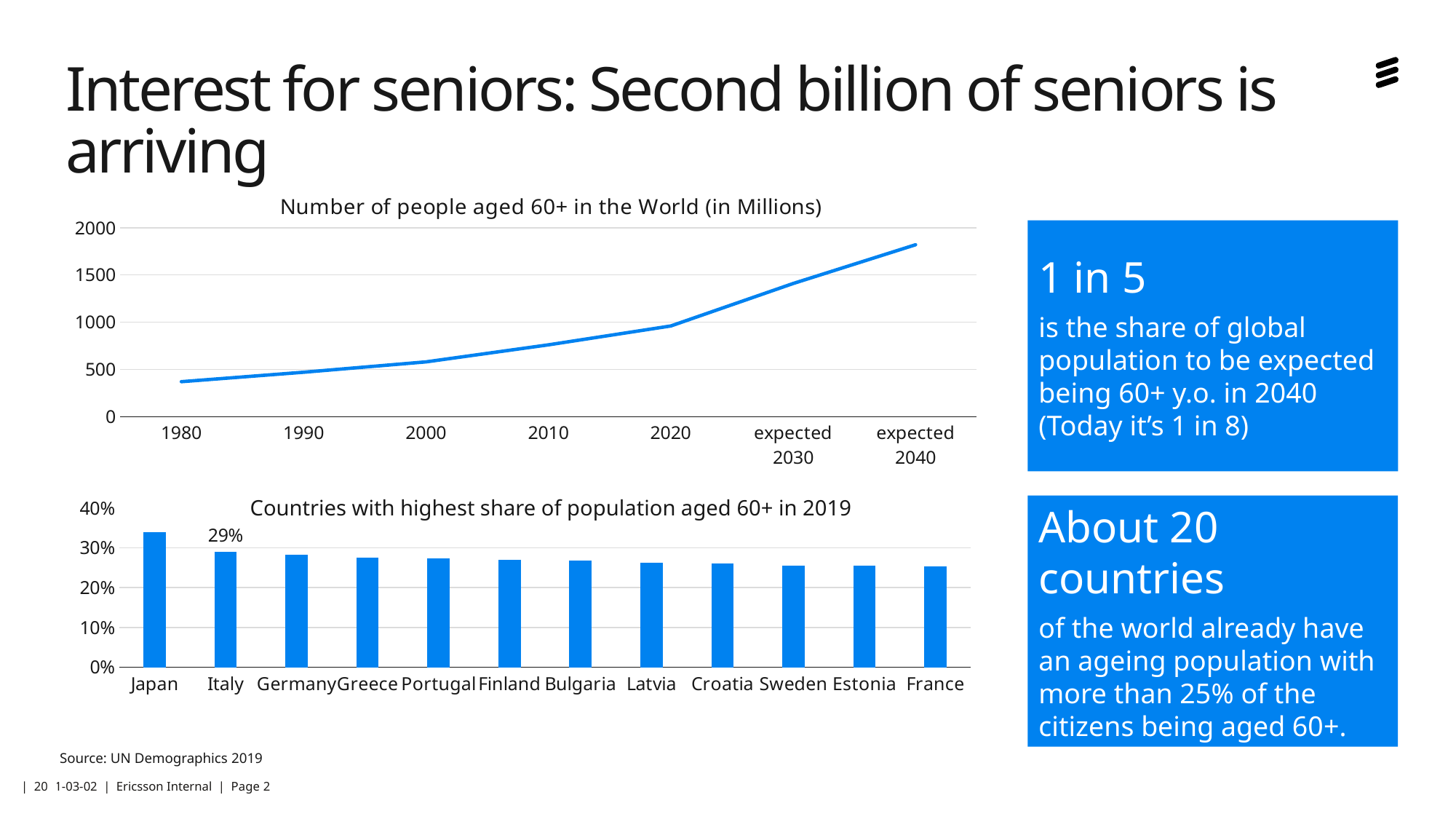
What kind of chart is the 'Countries with highest share of population aged 60+ in 2019' chart? bar chart In the 'Number of people aged 60+ in the World (in Millions)' chart, how many points are plotted along the x axis? 7 In the 'Countries with highest share of population aged 60+ in 2019' chart, which country has the highest share? Japan In the 'Number of people aged 60+ in the World (in Millions)' chart, is the value for expected 2040 greater or less than 1500? greater What kind of chart is the 'Number of people aged 60+ in the World (in Millions)' chart? line chart In the 'Countries with highest share of population aged 60+ in 2019' chart, is the value for Japan greater or less than 30%? greater In the 'Countries with highest share of population aged 60+ in 2019' chart, which is larger, the value for Japan or the value for Italy? Japan In the 'Countries with highest share of population aged 60+ in 2019' chart, what is the value for Italy? 29% In the 'Number of people aged 60+ in the World (in Millions)' chart, do the values rise or fall from 1980 to expected 2040? rise In the 'Countries with highest share of population aged 60+ in 2019' chart, how many countries are shown? 12 In the 'Number of people aged 60+ in the World (in Millions)' chart, is the value for 2010 greater or less than 1000? less